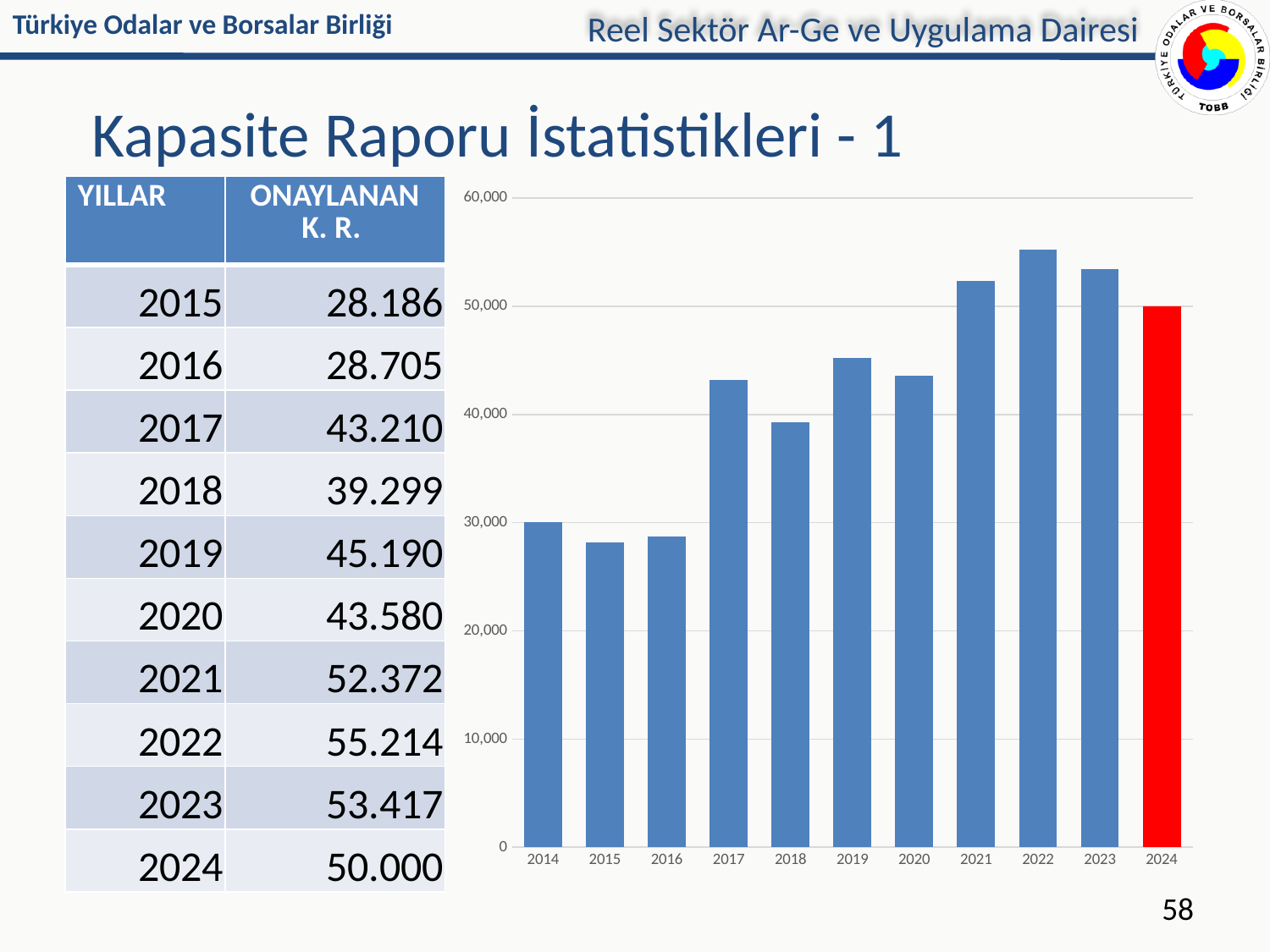
Which year's bar is coloured red in the chart? 2024 What is the value for 2018 in the chart? 39.299 What kind of chart is shown on the slide? bar chart How many years are shown on the x axis of the chart? 11 Which year has the highest value in the chart? 2022 What is the value for 2024 in the chart? 50.000 What is the value for 2022 in the chart? 55.214 What is the difference between the values for 2022 and 2021? 2.842 Which is larger, the value for 2017 or the value for 2018? 2017 Do the values rise or fall from 2022 to 2024? fall Which year has the lowest value in the chart? 2015 Is the value for 2014 greater or less than 40,000? less